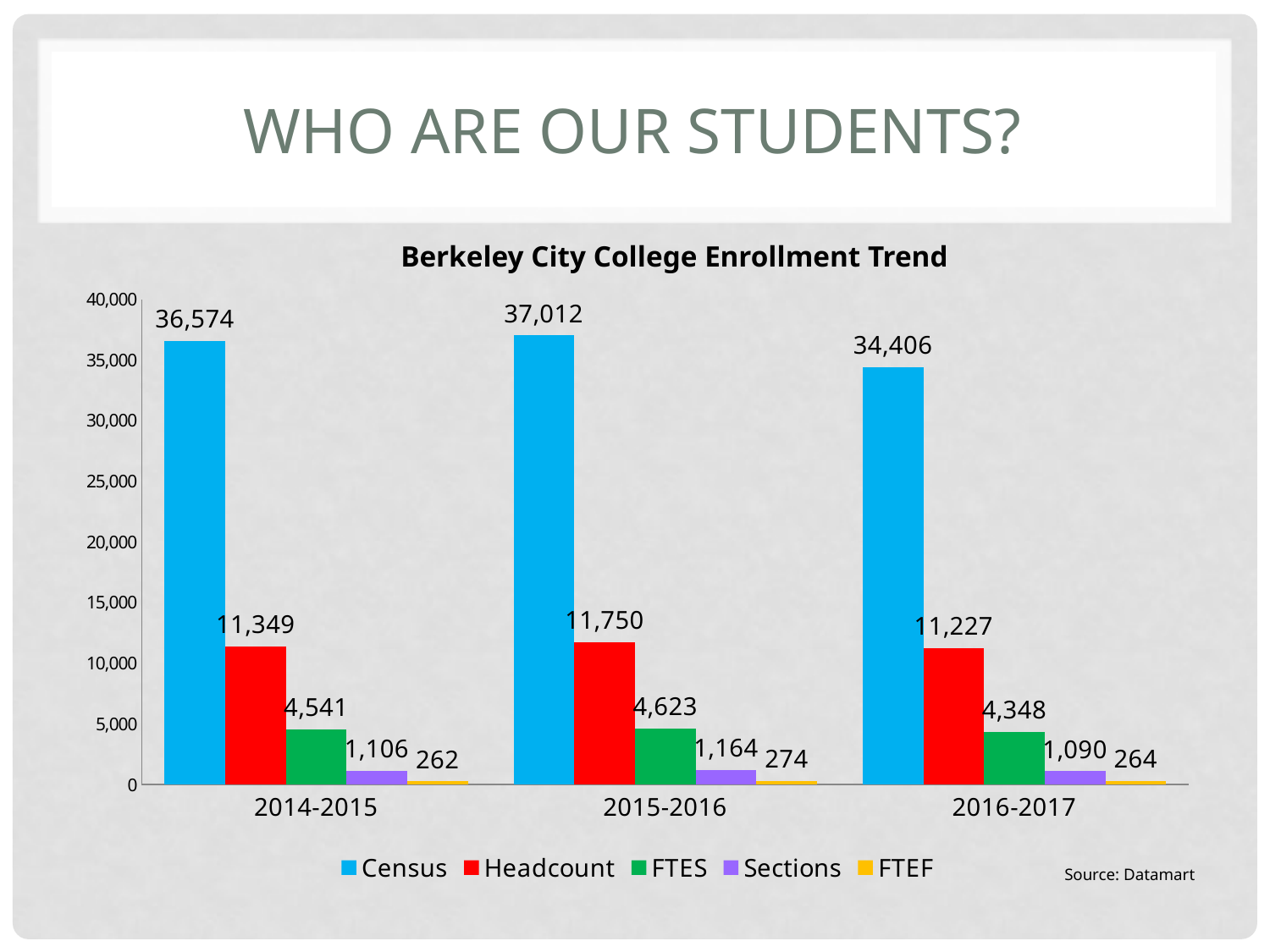
In which year is the Census value highest? 2015-2016 What is the FTES value for 2014-2015? 4,541 What is the difference between the Census values for 2015-2016 and 2016-2017? 2,606 In which year is the Sections value lowest? 2016-2017 What is the Headcount value for 2016-2017? 11,227 What is the FTEF value for 2015-2016? 274 How many series does the legend list? 5 How many years are shown on the x axis? 3 What kind of chart is shown on the slide? Bar chart What is the title of the chart? Berkeley City College Enrollment Trend What is the Census value for 2015-2016? 37,012 Which is larger, the Headcount for 2014-2015 or the Headcount for 2015-2016? 2015-2016